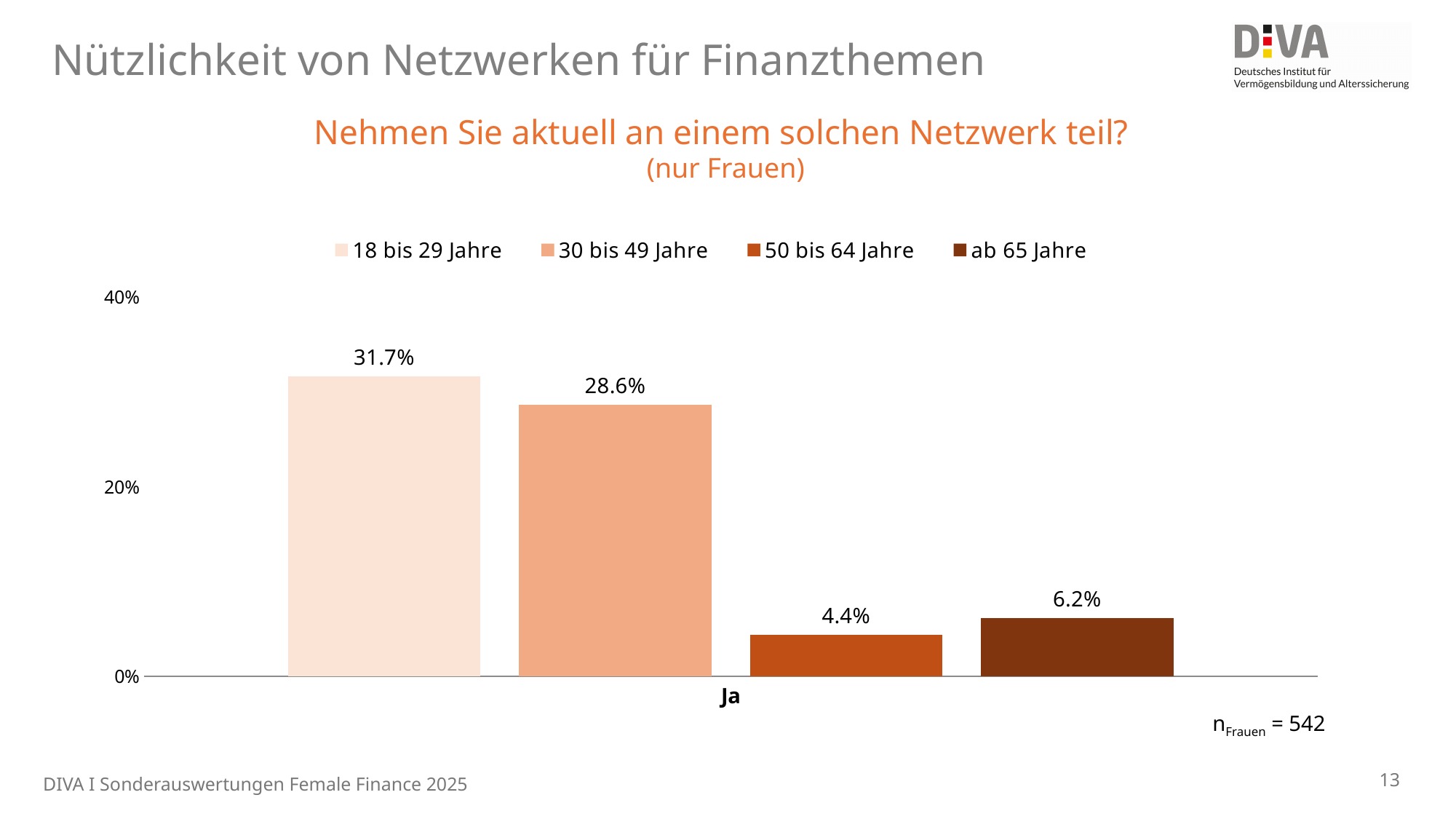
Which is larger, the value for ab 65 Jahre or the value for 50 bis 64 Jahre? ab 65 Jahre What is the value for the 50 bis 64 Jahre series? 4.4% What is the difference between the values for 18 bis 29 Jahre and 30 bis 49 Jahre? 3.1% What kind of chart is shown on the slide? bar chart Which age group has the highest value? 18 bis 29 Jahre What is the value for the 18 bis 29 Jahre series? 31.7% What is the value for the ab 65 Jahre series? 6.2% Which age group has the lowest value? 50 bis 64 Jahre What is the value for the 30 bis 49 Jahre series? 28.6% How many series does the legend list? 4 What is the category label shown on the x axis? Ja Is the value for 30 bis 49 Jahre greater or less than 20%? greater